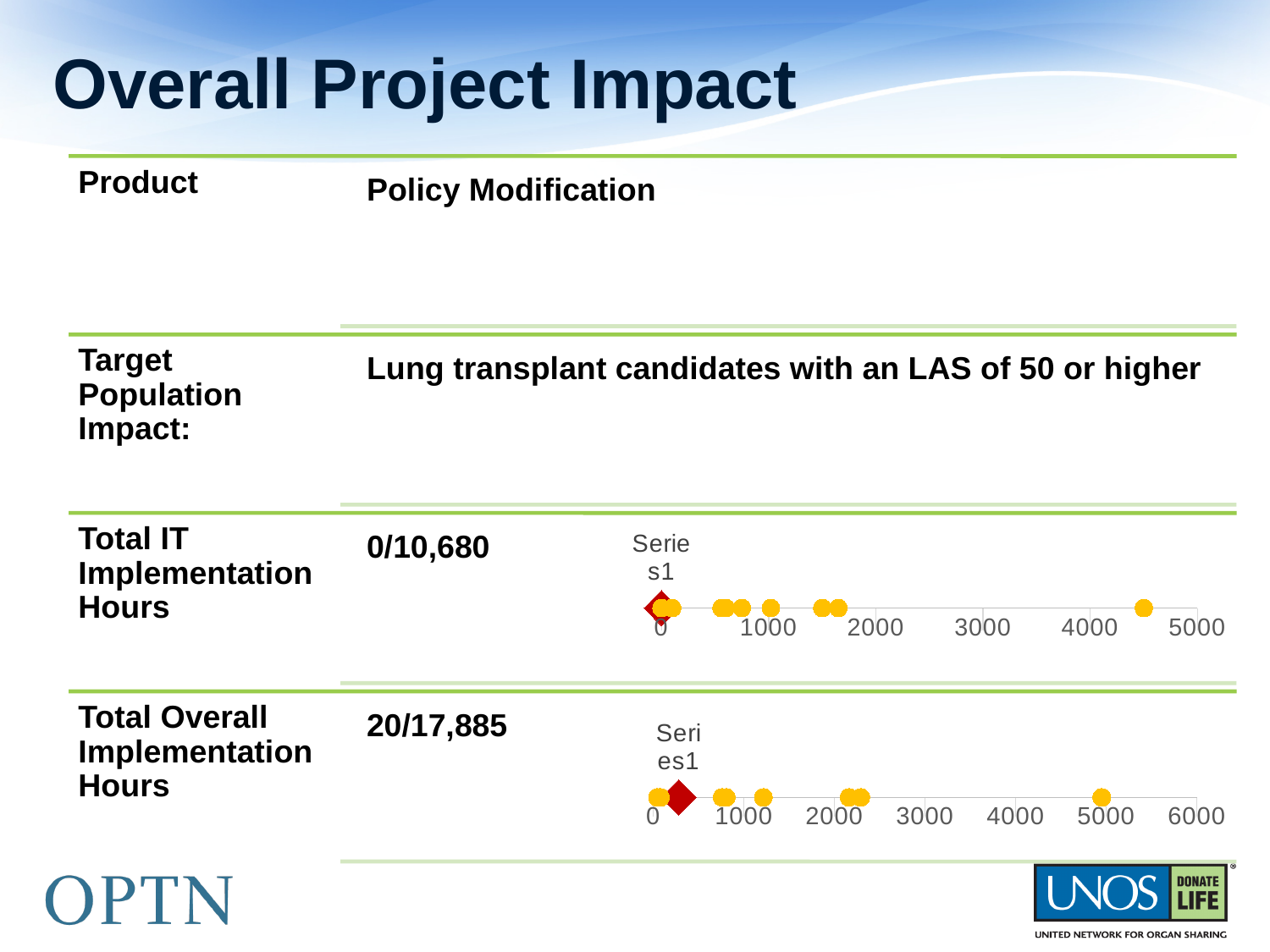
In the Total Overall Implementation Hours chart, is the rightmost yellow point greater or less than 4000? greater What kind of chart is shown next to Total Overall Implementation Hours? scatter chart In the Total IT Implementation Hours chart, is the red diamond marker greater or less than 1000? less What kind of chart is shown next to Total IT Implementation Hours? scatter chart How many tick labels are shown on the x axis of the Total IT Implementation Hours chart? 6 In the Total Overall Implementation Hours chart, what is the highest value labelled on the x axis? 6000 In the Total IT Implementation Hours chart, is the rightmost yellow point greater or less than 4000? greater In the Total Overall Implementation Hours chart, what is the name of the series in the legend? Series1 In the Total IT Implementation Hours chart, what is the highest value labelled on the x axis? 5000 In the Total IT Implementation Hours chart, how many series does the legend list? 1 How many tick labels are shown on the x axis of the Total Overall Implementation Hours chart? 7